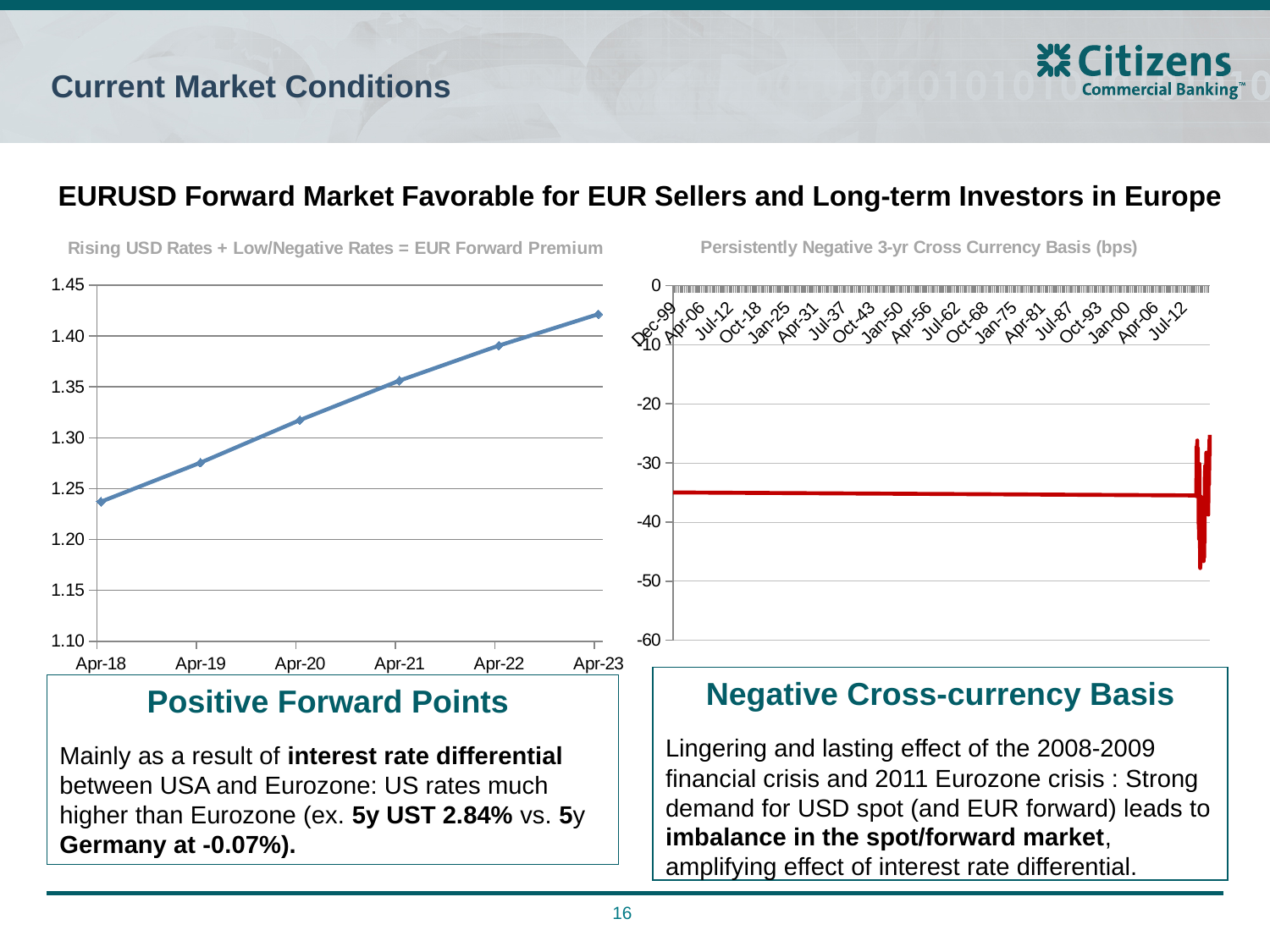
What kind of chart is the left chart titled 'Rising USD Rates + Low/Negative Rates = EUR Forward Premium'? Line chart In the left chart (EUR Forward Premium), which is larger, the value for Apr-22 or the value for Apr-19? Apr-22 In the right chart (3-yr Cross Currency Basis), is the value of the line for most of the period greater or less than -20? less What kind of chart is the right chart titled 'Persistently Negative 3-yr Cross Currency Basis (bps)'? Line chart In the left chart (EUR Forward Premium), is the value for Apr-18 greater or less than 1.25? less In the left chart (EUR Forward Premium), which x-axis date has the lowest value? Apr-18 What colour is the line in the right chart (3-yr Cross Currency Basis)? Red In the left chart (EUR Forward Premium), do the values rise or fall from Apr-18 to Apr-23? Rise In the left chart (EUR Forward Premium), is the value for Apr-23 greater or less than 1.40? greater In the left chart (EUR Forward Premium), which x-axis date has the highest value? Apr-23 How many data points are plotted on the line in the left chart (EUR Forward Premium)? 6